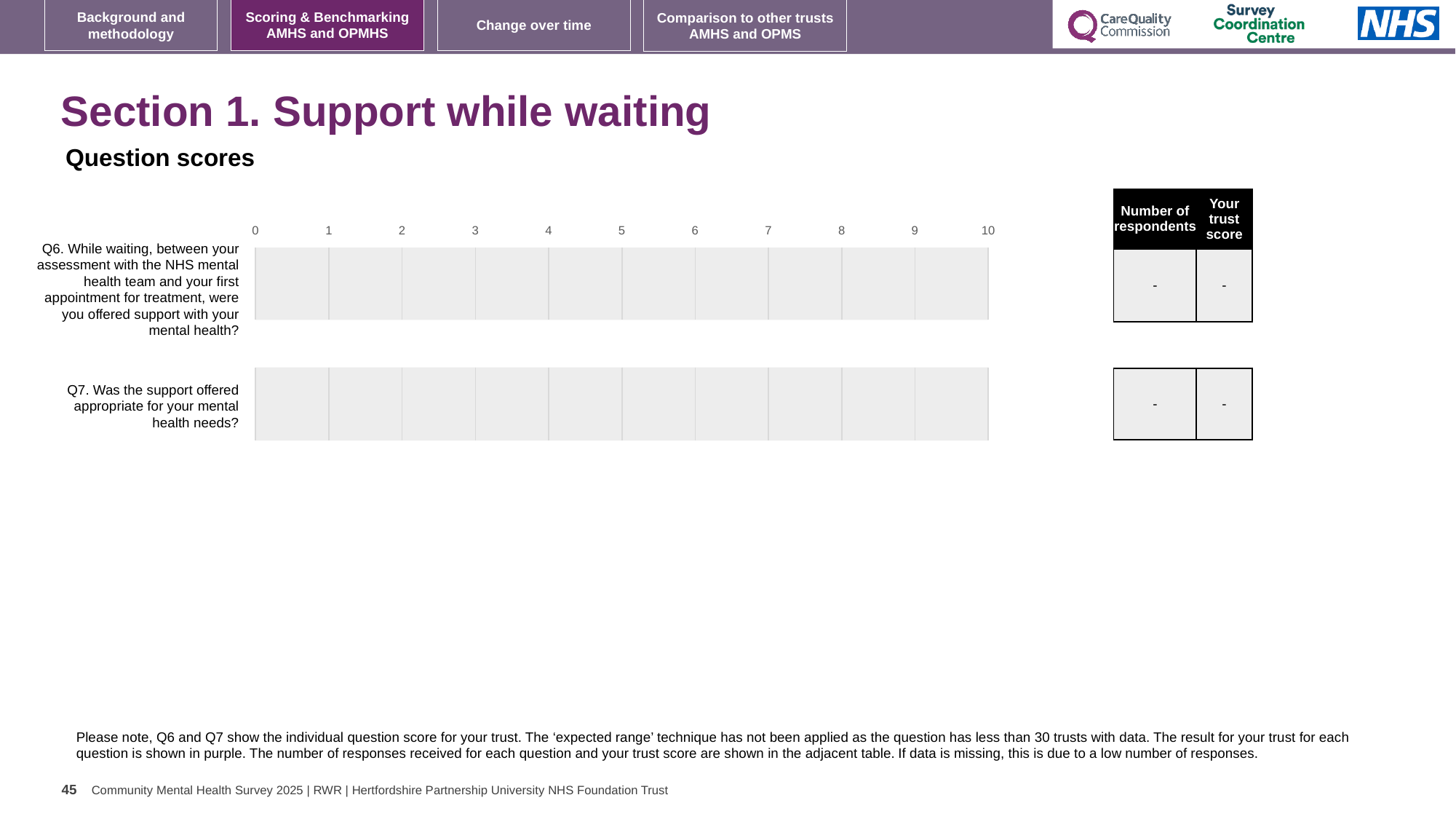
How many questions (categories) are listed on the chart? 2 What is the heading shown above the chart? Question scores What is the 'Your trust score' value shown for Q6 in the adjacent table? - What kind of chart is shown on the slide? bar chart What is the highest value shown on the chart's x axis? 10 What is the 'Number of respondents' value shown for Q7 in the adjacent table? -